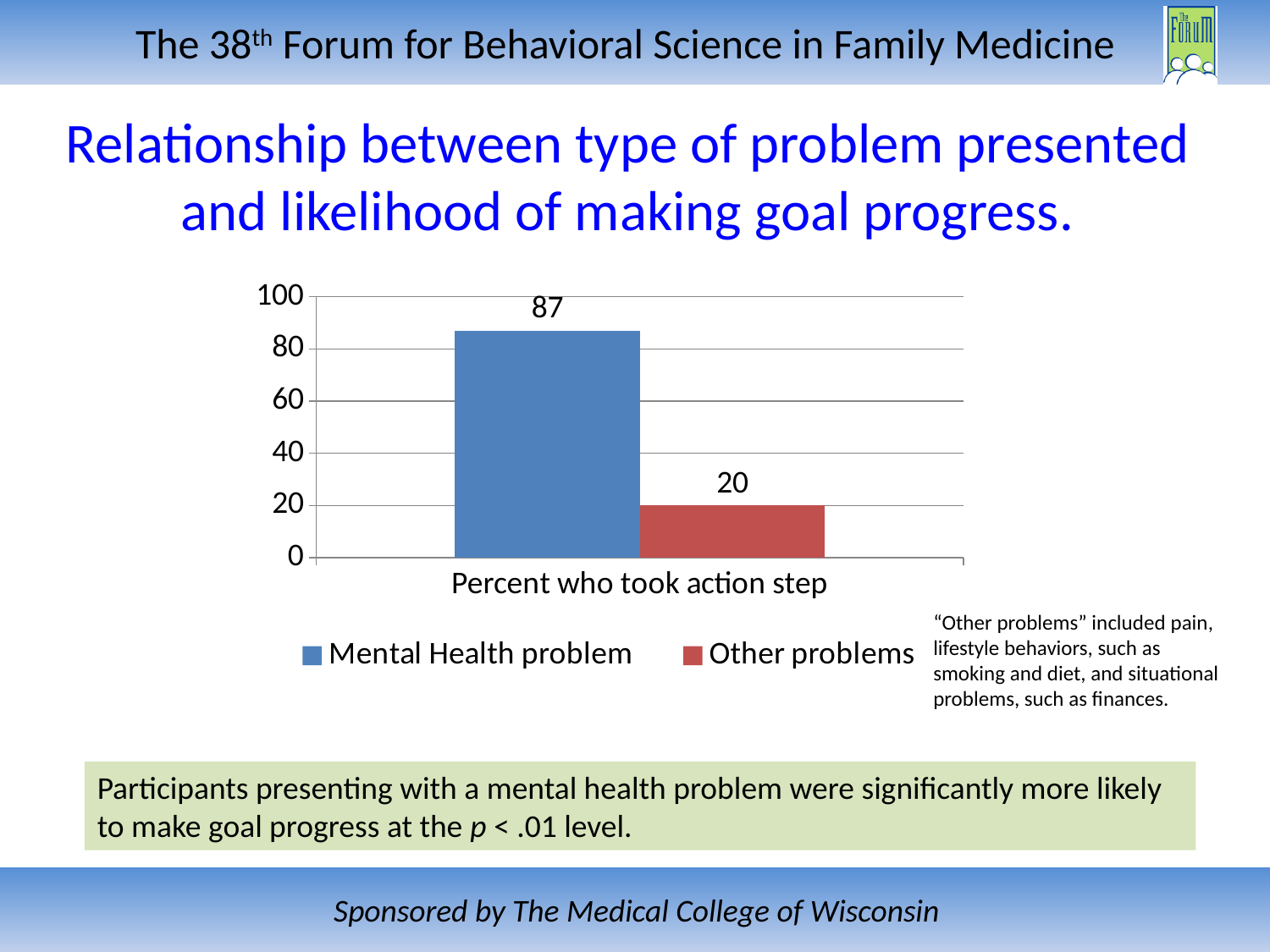
What kind of chart is shown on the slide? Bar chart Which series has the higher value, Mental Health problem or Other problems? Mental Health problem Is the value for Mental Health problem greater or less than 80? greater What is the difference between the values for Mental Health problem and Other problems? 67 What is the value for Mental Health problem in the chart? 87 Which series has the lowest value in the chart? Other problems Which series has the highest value in the chart? Mental Health problem Is the value for Other problems greater or less than 40? less What is the value for Other problems in the chart? 20 What is the category label shown on the x axis of the chart? Percent who took action step What colour is the bar for Other problems? Red How many series does the legend list? 2